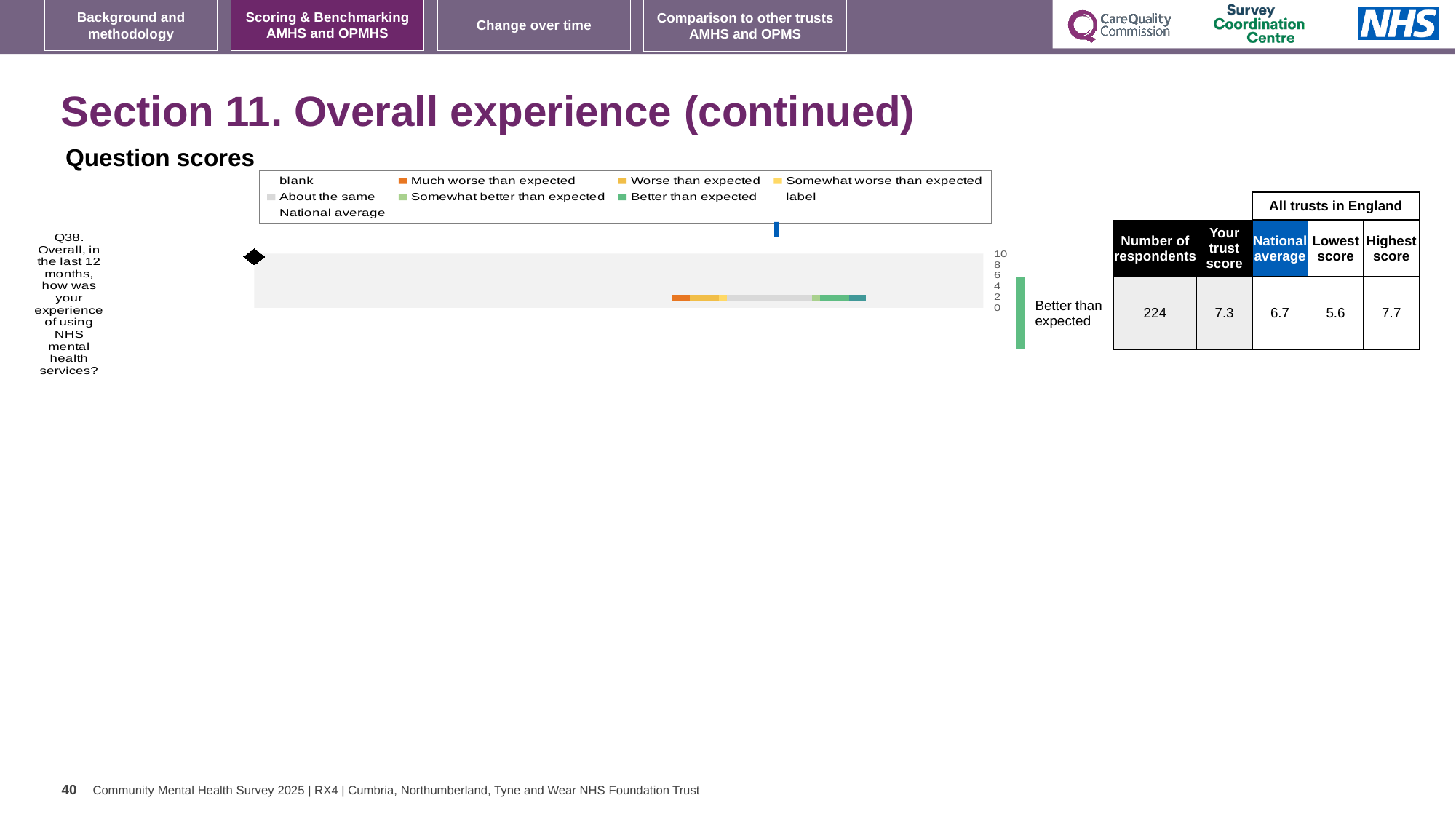
In the table beside the Question scores chart, what is the national average for Q38? 6.7 How many survey questions are plotted in the Question scores chart? 1 For Q38, which is larger: the trust's score or the national average? the trust's score In the table beside the Question scores chart, what is the highest score among all trusts in England for Q38? 7.7 For Q38, what is the difference between the highest score and the lowest score among all trusts in England? 2.1 Which question number is plotted in the Question scores chart? Q38 In the table beside the Question scores chart, what is the trust's score for Q38? 7.3 What kind of chart is shown under 'Question scores'? bar chart For Q38, how much higher is the trust's score than the national average? 0.6 In the table beside the Question scores chart, what is the lowest score among all trusts in England for Q38? 5.6 What benchmark label is shown to the right of the Q38 bar in the Question scores chart? Better than expected In the table beside the Question scores chart, how many respondents answered Q38? 224